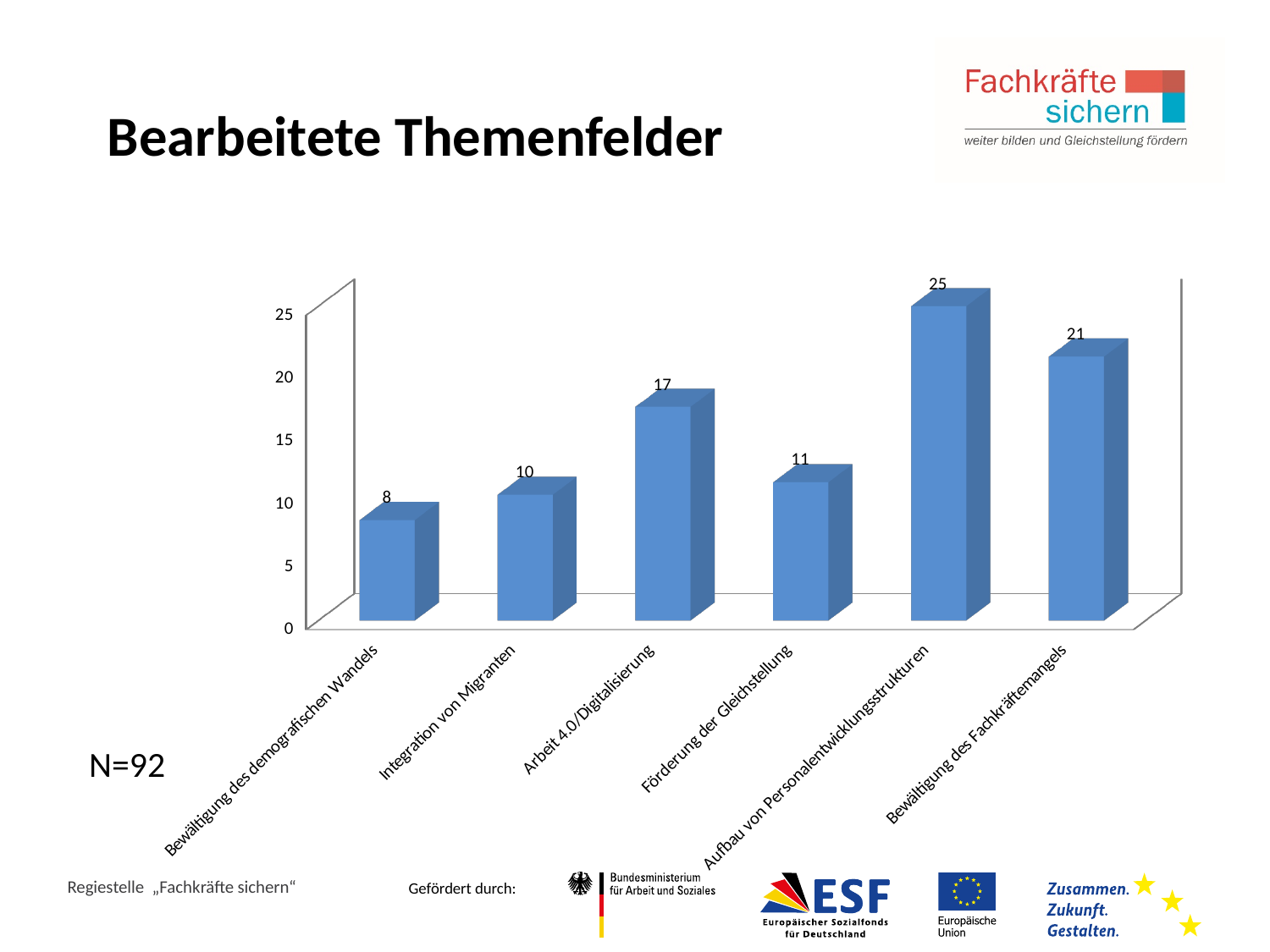
What is the value for Aufbau von Personalentwicklungsstrukturen? 25 What is the difference between the values for Bewältigung des Fachkräftemangels and Arbeit 4.0/Digitalisierung? 4 What is the value for Förderung der Gleichstellung? 11 What is the value for Bewältigung des demografischen Wandels? 8 Which category has the highest value? Aufbau von Personalentwicklungsstrukturen What kind of chart is shown on the slide? bar chart How many categories are shown in the chart? 6 Which is larger, the value for Integration von Migranten or the value for Förderung der Gleichstellung? Förderung der Gleichstellung Is the value for Arbeit 4.0/Digitalisierung greater or less than 15? greater What sample size (N) is stated on the slide? N=92 What is the title of the slide? Bearbeitete Themenfelder Which category has the lowest value? Bewältigung des demografischen Wandels